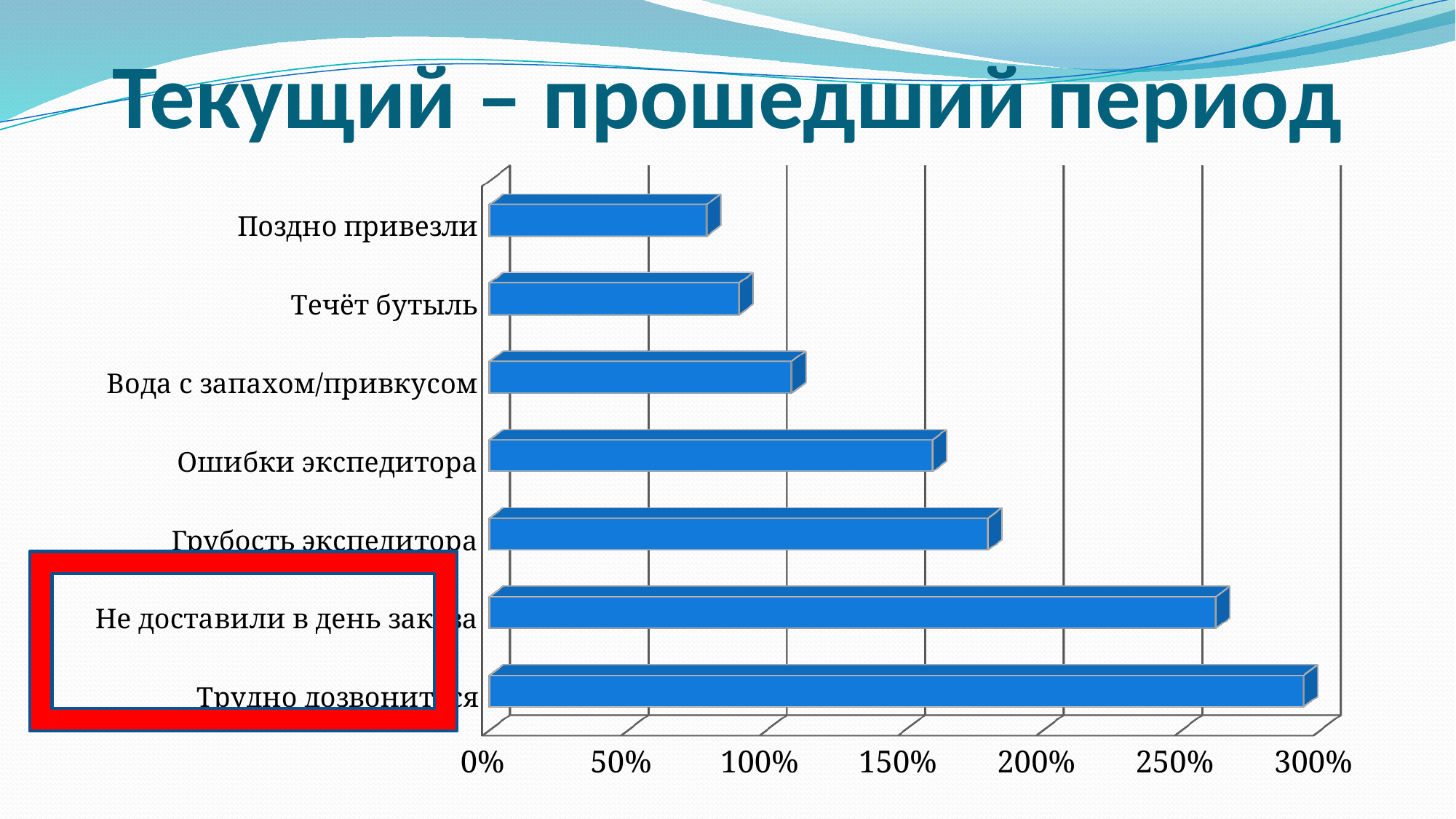
Which is larger: the value for Не доставили в день заказа or the value for Грубость экспедитора? Не доставили в день заказа What kind of chart is shown on the slide? bar chart Is the value for Поздно привезли greater or less than 100%? less How many categories are plotted in the chart? 7 What is the title of the slide containing the chart? Текущий – прошедший период Is the value for Грубость экспедитора greater or less than 200%? less Is the value for Течёт бутыль greater or less than 50%? greater Which category has the highest value in the chart? Трудно дозвониться Which is larger: the value for Ошибки экспедитора or the value for Вода с запахом/привкусом? Ошибки экспедитора Which category has the lowest value in the chart? Поздно привезли